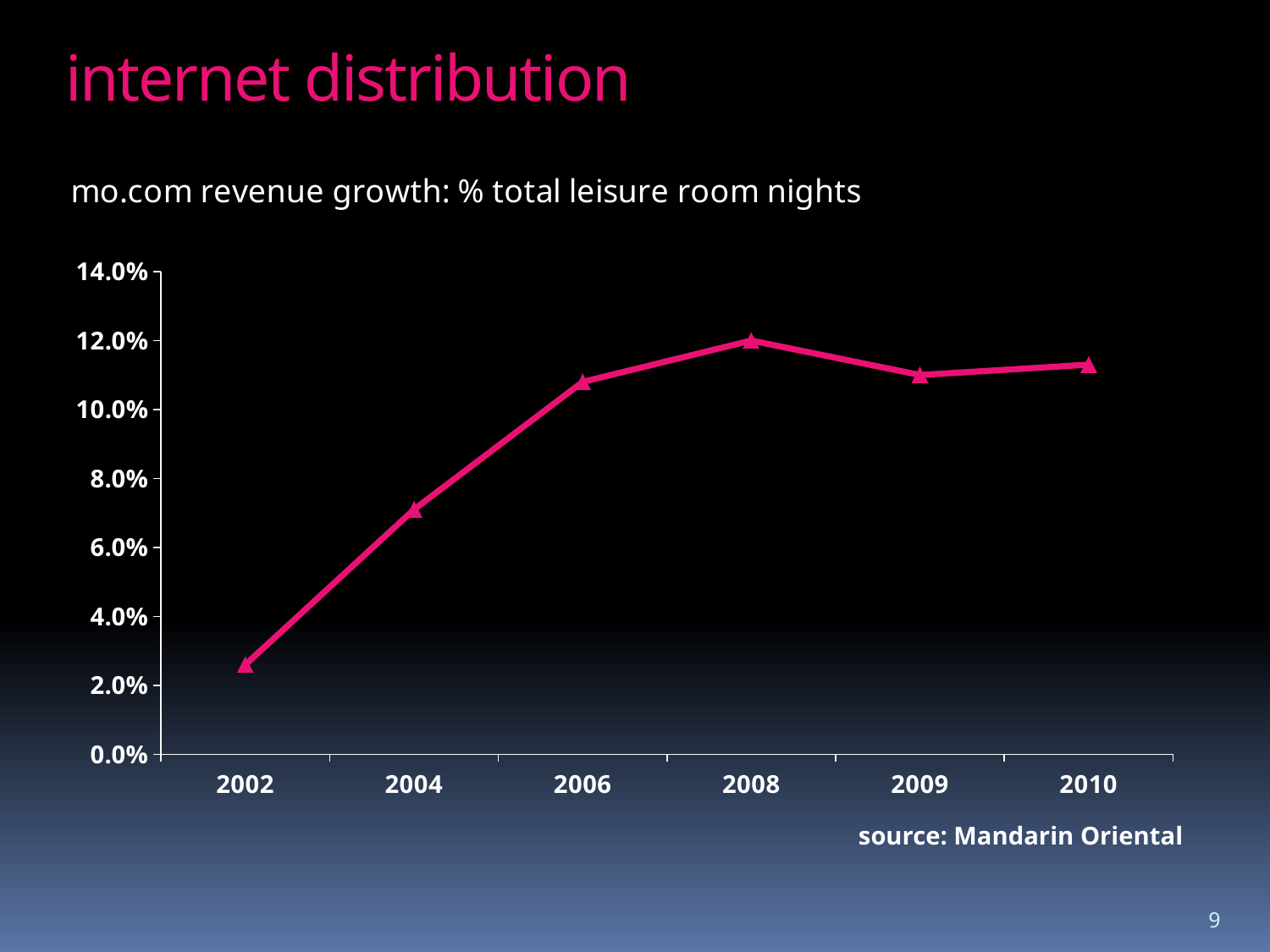
Which is larger, the value for 2004 or the value for 2006? 2006 Is the value for 2002 greater or less than 4.0%? less What kind of chart is shown on the slide? line chart Is the value for 2004 greater or less than 6.0%? greater Is the value for 2006 greater or less than 10.0%? greater Do the values rise or fall from 2002 to 2008? rise Which year has the lowest value on the chart? 2002 How many data points are plotted on the chart? 6 Which year has the highest value on the chart? 2008 What is the source cited for the chart? Mandarin Oriental What is the value for 2008? 12.0%